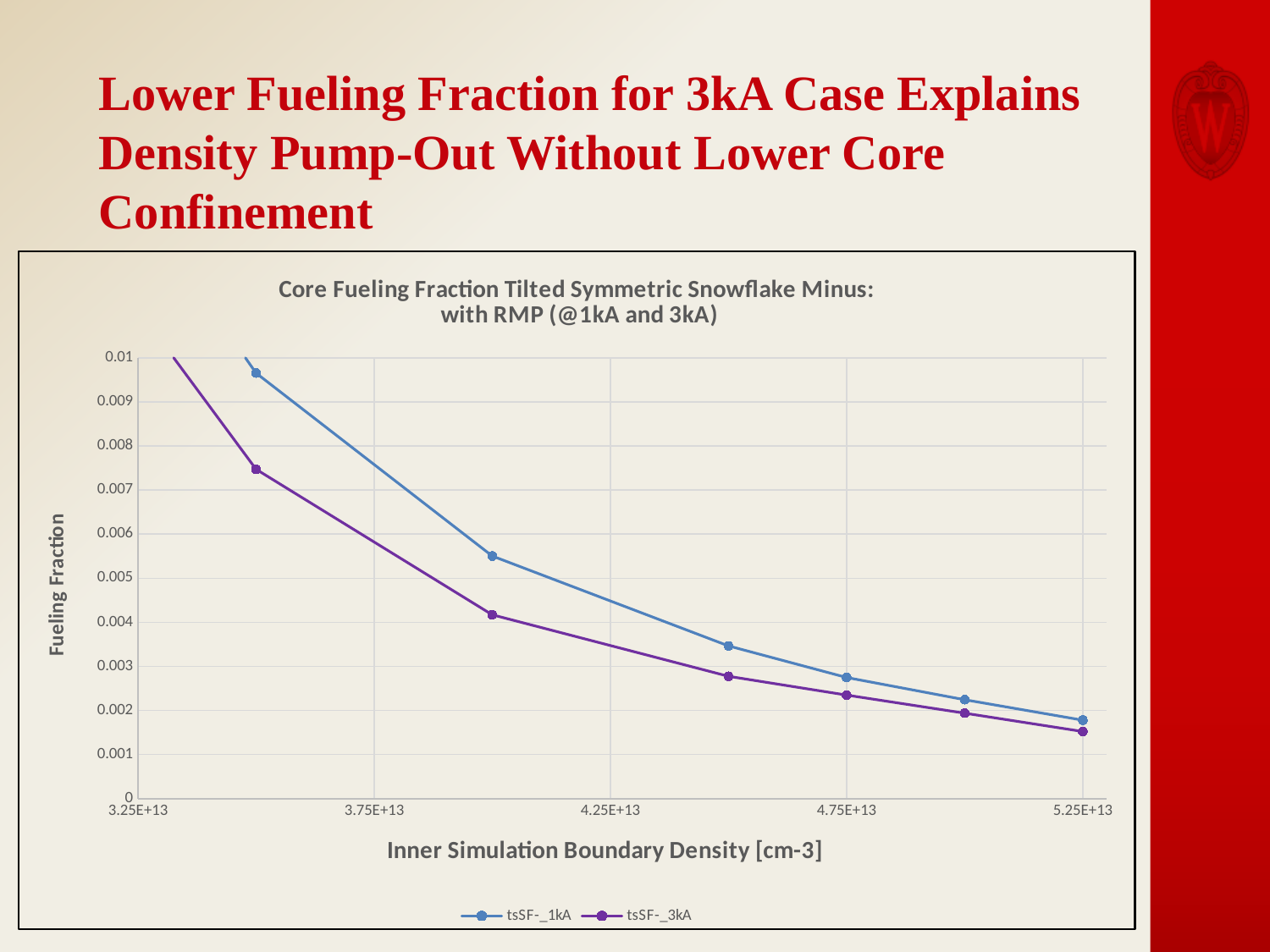
Is the fueling fraction for tsSF-_3kA at 4.75E+13 greater or less than 0.003? less Which series lies lower across the whole density range, tsSF-_1kA or tsSF-_3kA? tsSF-_3kA How many series does the legend list? 2 How many marked data points does the tsSF-_3kA series show? 6 What are the names of the two series in the legend? tsSF-_1kA and tsSF-_3kA Is the fueling fraction for tsSF-_3kA at 5.25E+13 greater or less than 0.002? less What is the label of the x axis? Inner Simulation Boundary Density [cm-3] Is the fueling fraction for tsSF-_1kA at 5.25E+13 greater or less than 0.002? less Does the fueling fraction rise or fall as the inner simulation boundary density increases? fall Which series has the higher fueling fraction at 4.75E+13, tsSF-_1kA or tsSF-_3kA? tsSF-_1kA What kind of chart is shown on the slide? line chart